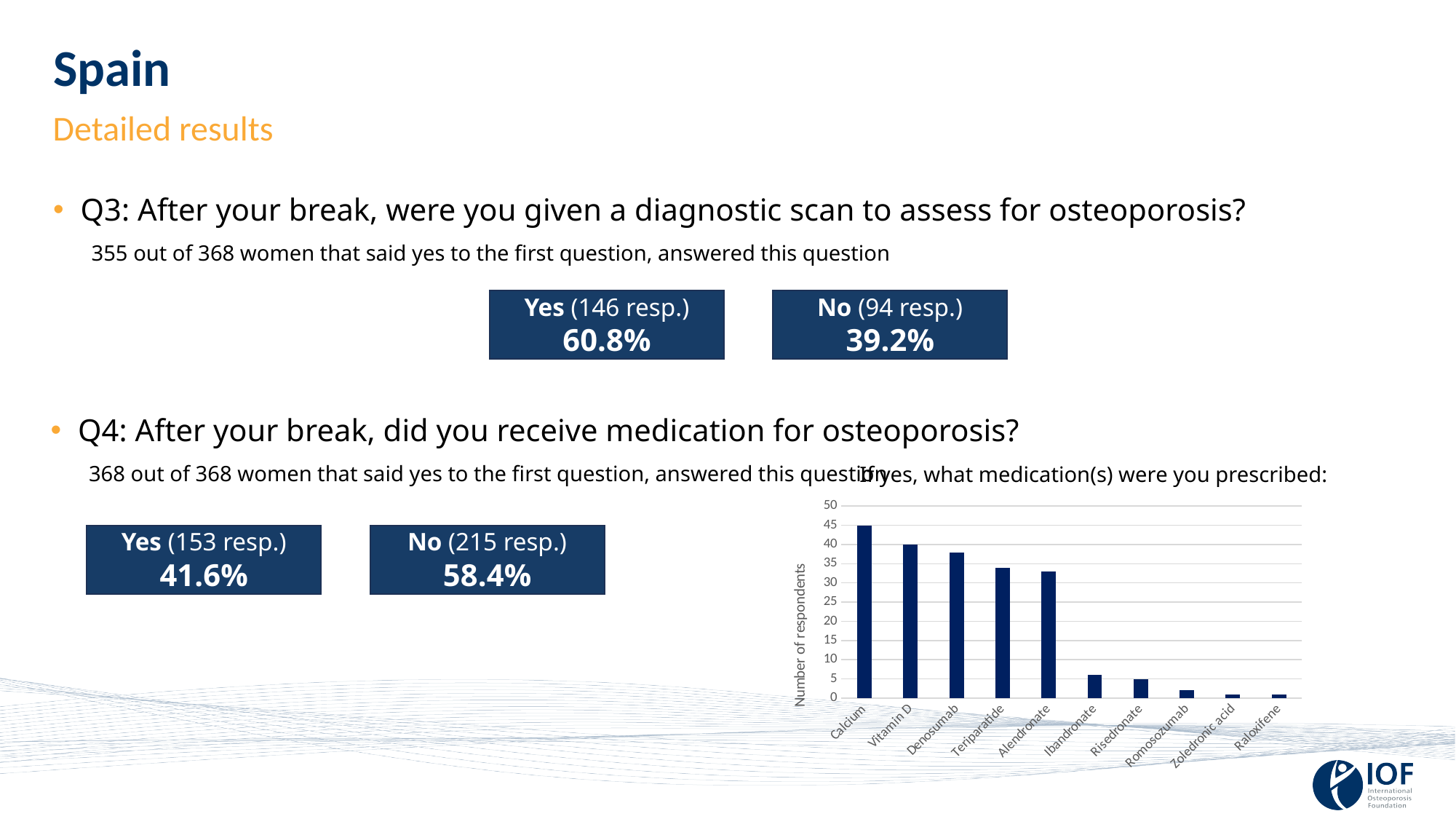
What is the label of the vertical axis of the chart? Number of respondents Is the value for Denosumab greater or less than 35? greater What is the number of respondents for Calcium in the chart? 45 What kind of chart is shown on the slide? bar chart What is the number of respondents for Vitamin D in the chart? 40 Do the values in the chart rise or fall from left to right along the x axis? fall Is the value for Ibandronate greater or less than 10? less How many medication categories are shown on the x axis of the chart? 10 Is the value for Alendronate greater or less than 30? greater Which has more respondents in the chart, Teriparatide or Ibandronate? Teriparatide Which medication has the highest number of respondents in the chart? Calcium